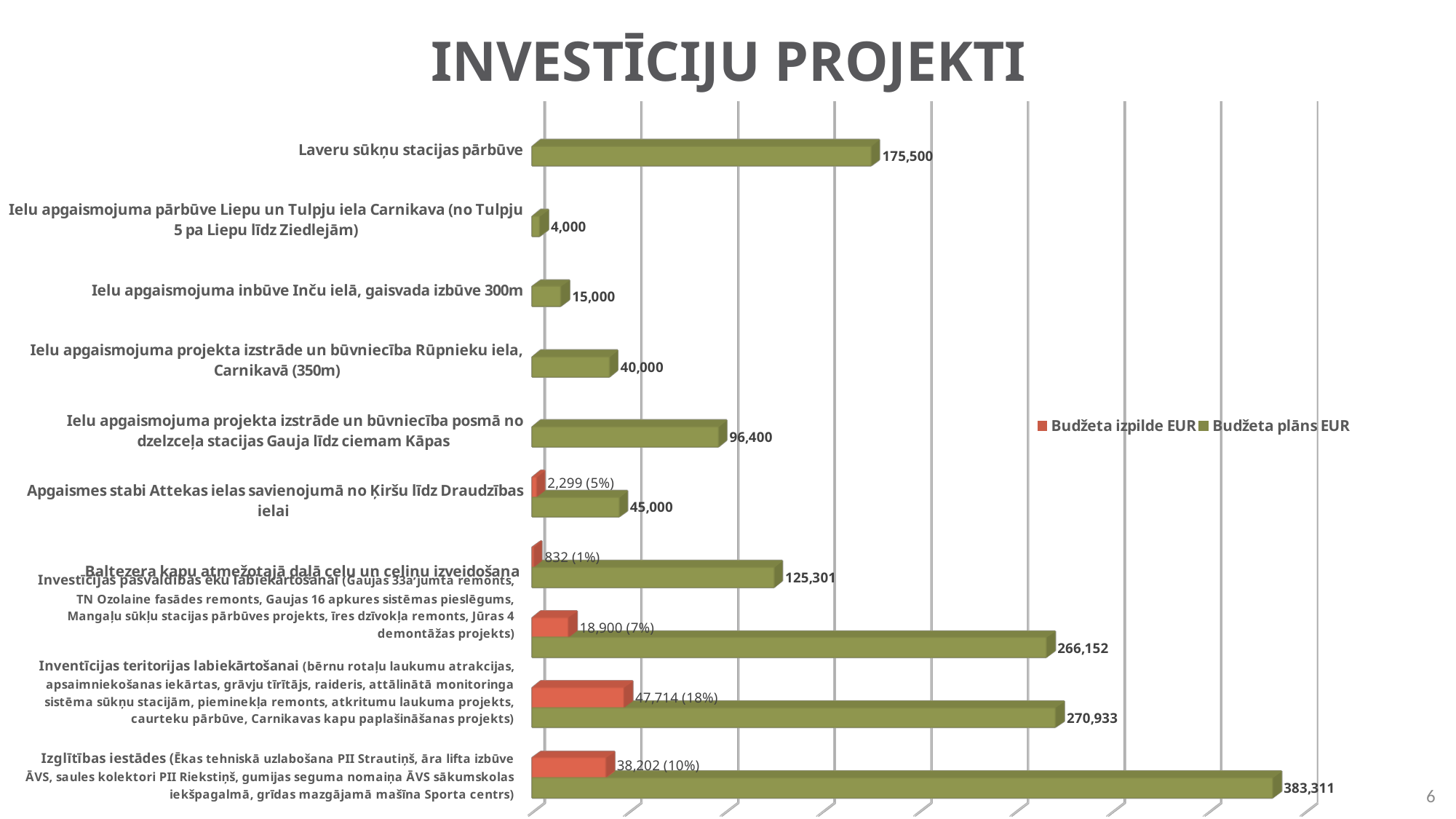
How many categories are shown on the chart? 10 What is the Budžeta plāns EUR value for Laveru sūkņu stacijas pārbūve? 175,500 What kind of chart is shown on the slide? Bar chart What is the Budžeta plāns EUR value for Baltezera kapu atmežotajā daļā ceļu un celiņu izveidošana? 125,301 What is the Budžeta izpilde EUR value for Izglītības iestādes? 38,202 (10%) Which colour represents the Budžeta izpilde EUR series? Red What is the difference between the Budžeta plāns EUR values for Inventīcijas teritorijas labiekārtošanai and Investīcijas pašvaldības ēku labiekārtošanai? 4,781 How many series does the legend list? 2 Which category has the highest Budžeta plāns EUR value? Izglītības iestādes Which category has the lowest Budžeta plāns EUR value? Ielu apgaismojuma pārbūve Liepu un Tulpju iela Carnikava (no Tulpju 5 pa Liepu līdz Ziedlejām) Which is larger: the Budžeta plāns EUR value for Laveru sūkņu stacijas pārbūve or for Baltezera kapu atmežotajā daļā ceļu un celiņu izveidošana? Laveru sūkņu stacijas pārbūve What is the Budžeta izpilde EUR value for Inventīcijas teritorijas labiekārtošanai? 47,714 (18%)